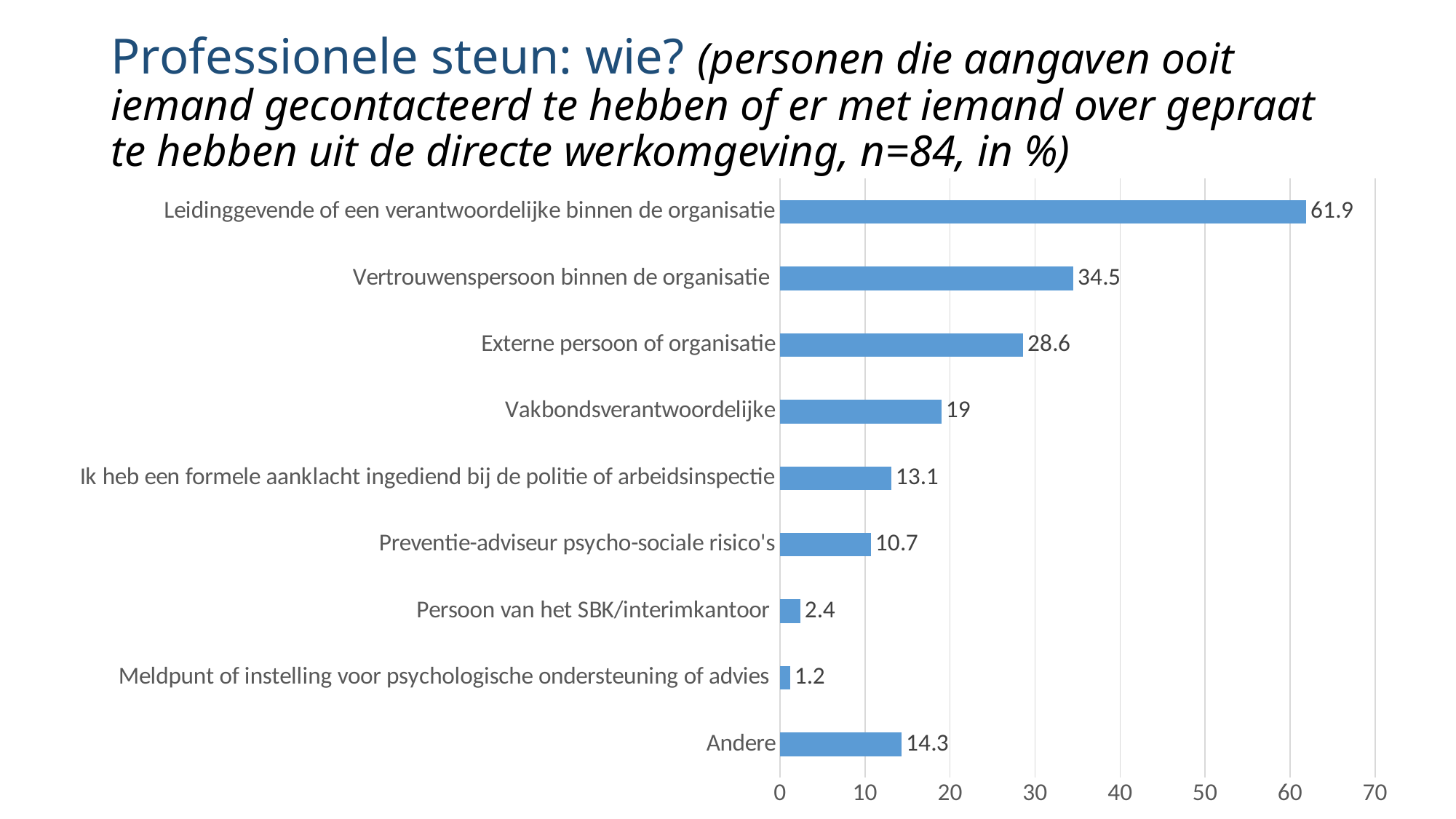
What is the value for 'Andere'? 14.3 Which category has the highest value? Leidinggevende of een verantwoordelijke binnen de organisatie What is the difference between the values for 'Vertrouwenspersoon binnen de organisatie' and 'Externe persoon of organisatie'? 5.9 What is the maximum value shown on the horizontal axis? 70 Is the value for 'Preventie-adviseur psycho-sociale risico's' greater or less than 20? less What kind of chart is shown on the slide? bar chart Which is larger: the value for 'Andere' or the value for 'Ik heb een formele aanklacht ingediend bij de politie of arbeidsinspectie'? Andere What is the value for 'Leidinggevende of een verantwoordelijke binnen de organisatie'? 61.9 What is the value for 'Vakbondsverantwoordelijke'? 19 How many categories are shown in the chart? 9 What is the value for 'Vertrouwenspersoon binnen de organisatie'? 34.5 Which category has the lowest value? Meldpunt of instelling voor psychologische ondersteuning of advies